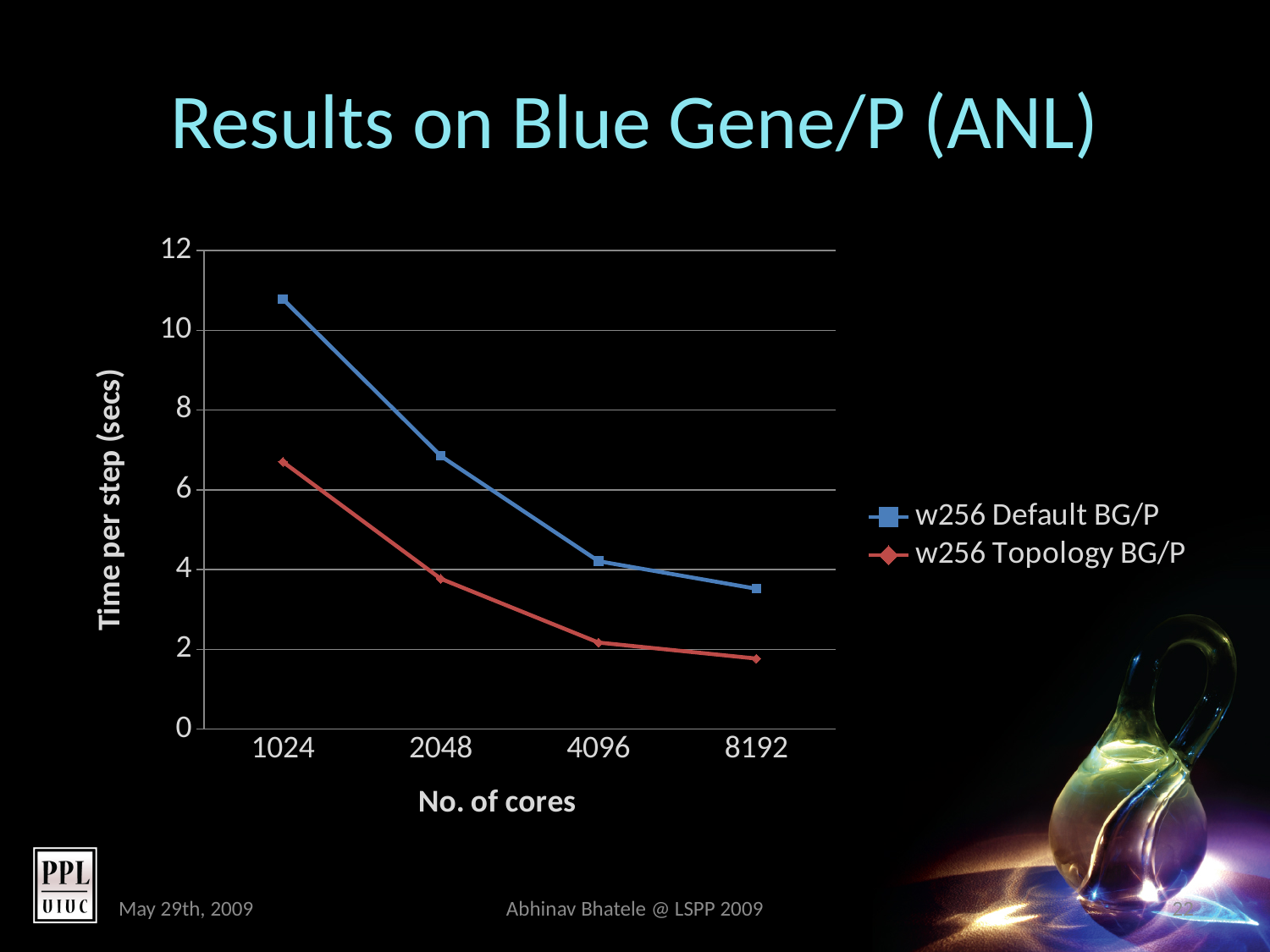
At 4096 cores, which series has the higher time per step, w256 Default BG/P or w256 Topology BG/P? w256 Default BG/P What is the label of the y axis? Time per step (secs) Is the time per step for w256 Topology BG/P at 2048 cores greater or less than 6? less Does the time per step for w256 Topology BG/P rise or fall as the number of cores increases? fall Does the time per step for w256 Default BG/P rise or fall as the number of cores increases? fall At which number of cores is the time per step for w256 Default BG/P highest? 1024 Is the time per step for w256 Topology BG/P at 1024 cores greater or less than 6? greater Is the time per step for w256 Default BG/P at 1024 cores greater or less than 10? greater What kind of chart is shown on the slide? line chart How many core counts are plotted along the x axis? 4 How many series does the legend list? 2